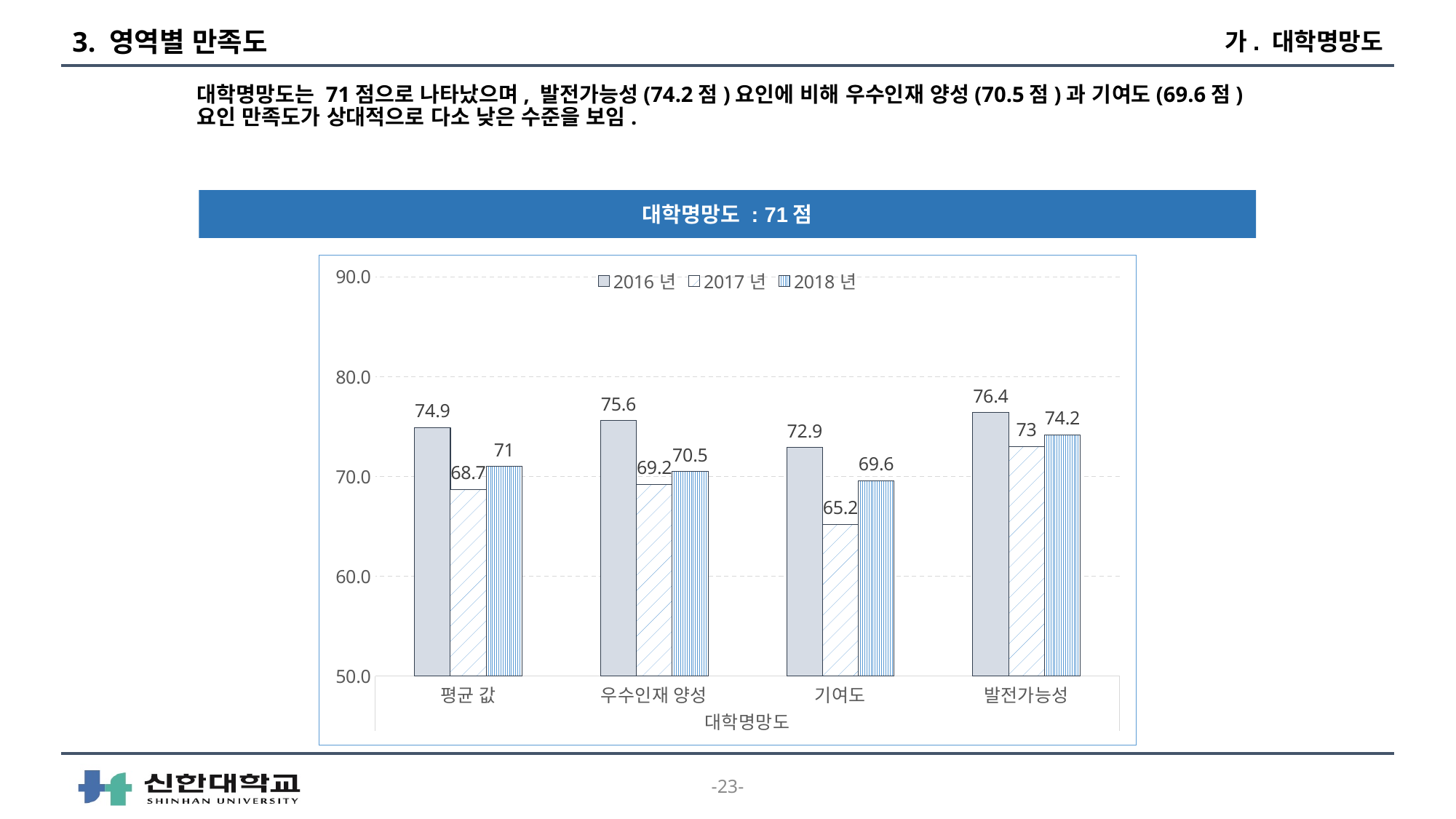
Which category has the lowest 2017 년 value? 기여도 What is the x-axis title of the chart? 대학명망도 What is the difference between the 2016 년 and 2017 년 values for 평균 값? 6.2 What is the 2017 년 value for 기여도? 65.2 How many categories are shown on the x axis? 4 What kind of chart is shown on the slide? bar chart Is the 2017 년 value for 기여도 greater or less than 70.0? less Which category has the highest 2016 년 value? 발전가능성 How many series does the legend list? 3 Which is larger for 기여도: the 2016 년 value or the 2018 년 value? 2016 년 What is the 2018 년 value for 발전가능성? 74.2 What is the 2016 년 value for 우수인재 양성? 75.6